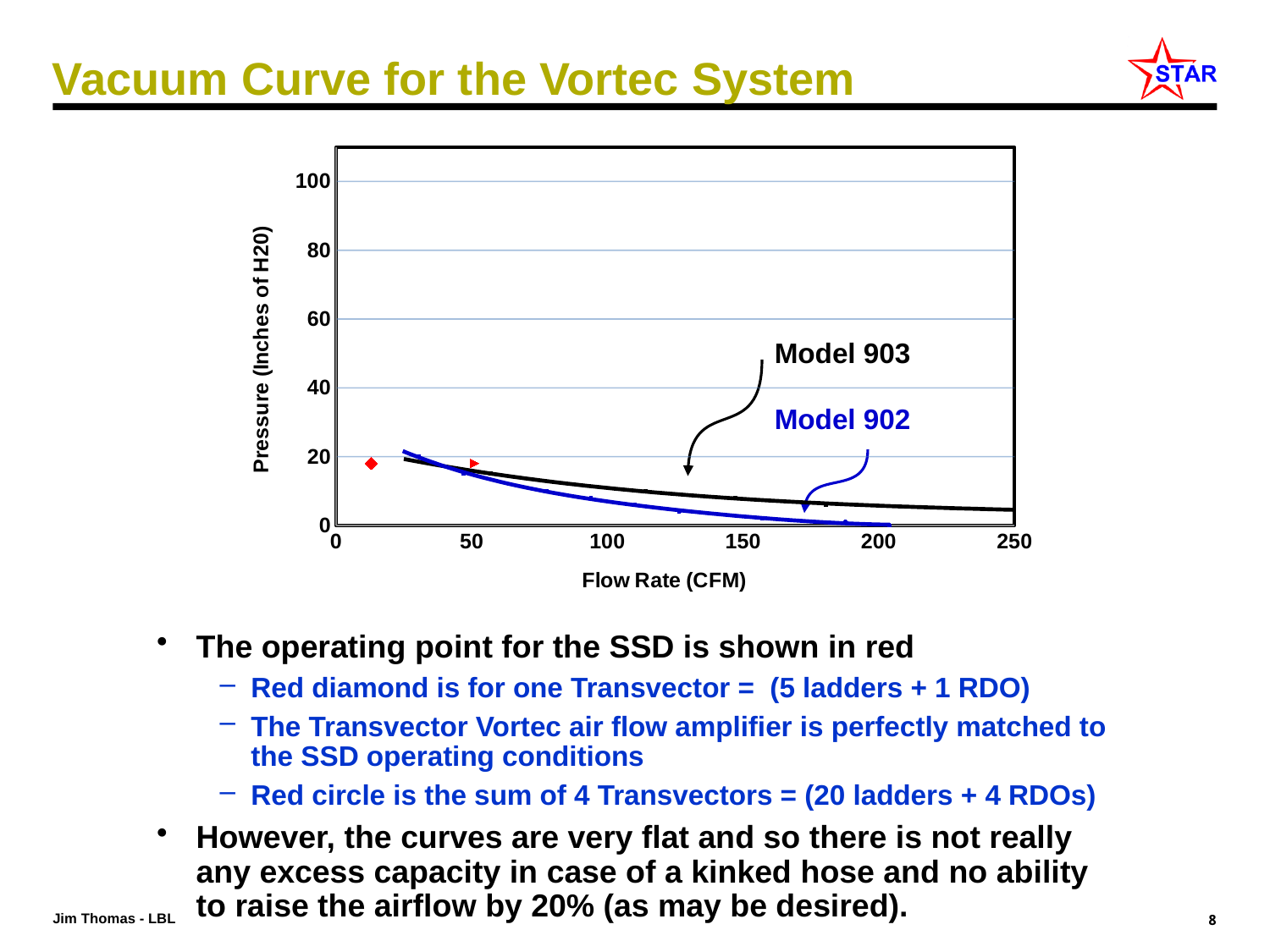
What is the title of the chart's y axis? Pressure (Inches of H20) At a flow rate of 150 CFM, which curve shows the higher pressure, Model 903 or Model 902? Model 903 As flow rate increases, does the pressure for Model 902 rise or fall? fall As flow rate increases, does the pressure for Model 903 rise or fall? fall How many model curves are plotted on the chart? 2 What kind of chart is shown on the slide? line chart Which model curve reaches zero pressure at the lower flow rate? Model 902 Is the pressure for Model 902 at 200 CFM greater or less than 20? less Which model curve is drawn in blue? Model 902 Is the pressure at the red diamond operating point greater or less than 40? less Is the pressure for Model 903 at 250 CFM greater or less than 20? less What is the title of the chart's x axis? Flow Rate (CFM)